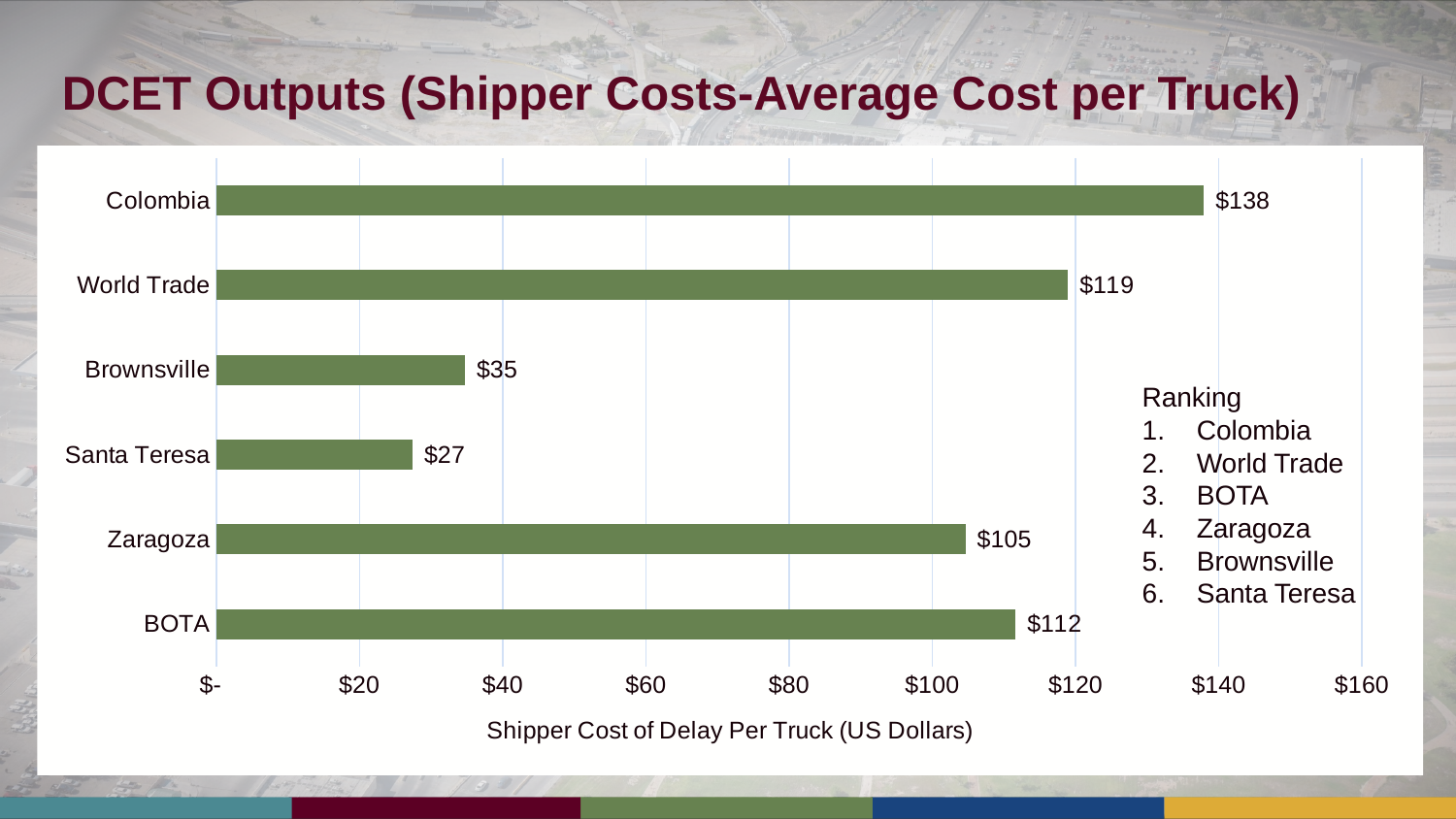
What is the label of the horizontal axis of the chart? Shipper Cost of Delay Per Truck (US Dollars) What is the difference between the shipper cost per truck for BOTA and Zaragoza? $7 Which crossing has the lowest shipper cost of delay per truck? Santa Teresa What is the difference between the shipper cost per truck for Colombia and World Trade? $19 How many crossings are shown in the chart? 6 Which has a higher shipper cost per truck, Brownsville or Santa Teresa? Brownsville Is the value for World Trade greater or less than $100? greater What kind of chart is shown on the slide? Bar chart What is the shipper cost of delay per truck for Colombia? $138 What is the shipper cost of delay per truck for Santa Teresa? $27 What is the shipper cost of delay per truck for BOTA? $112 Which crossing has the highest shipper cost of delay per truck? Colombia